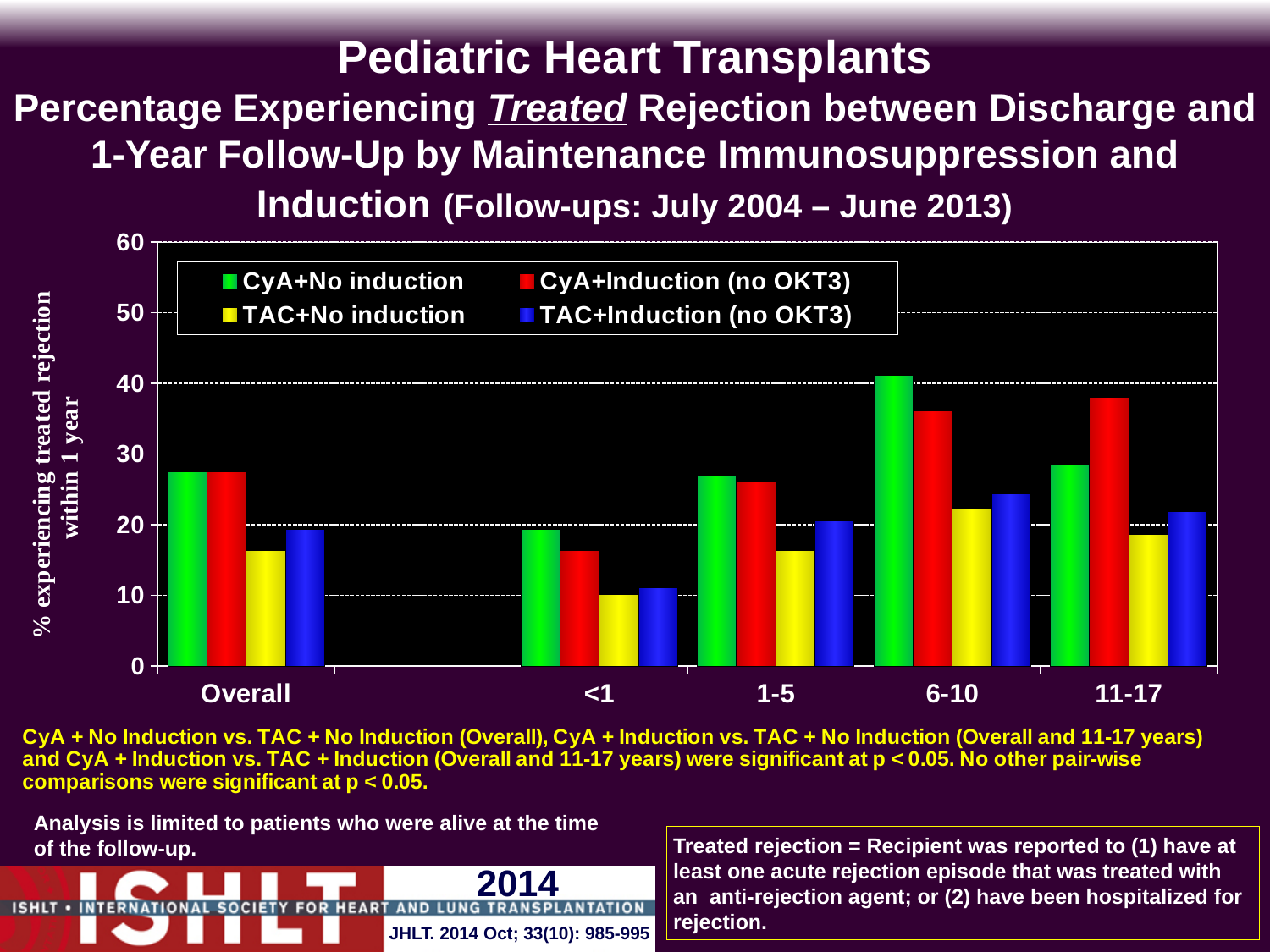
Which age group has the highest value for CyA+No induction? 6-10 Which age group has the lowest value for TAC+No induction? <1 Is the value for TAC+No induction in the <1 age group greater or less than 20? less How many categories are shown along the x axis? 5 Which series has the highest value in the 11-17 age group? CyA+Induction (no OKT3) What colour represents TAC+Induction (no OKT3) in the chart? blue How many series does the legend list? 4 Does the value for CyA+Induction (no OKT3) rise or fall across the age groups from <1 to 11-17? rise In the 6-10 age group, which is larger: CyA+No induction or CyA+Induction (no OKT3)? CyA+No induction Is the value for CyA+No induction in the 6-10 age group greater or less than 30? greater What kind of chart is shown on the slide? bar chart In the 11-17 age group, which is larger: CyA+Induction (no OKT3) or CyA+No induction? CyA+Induction (no OKT3)